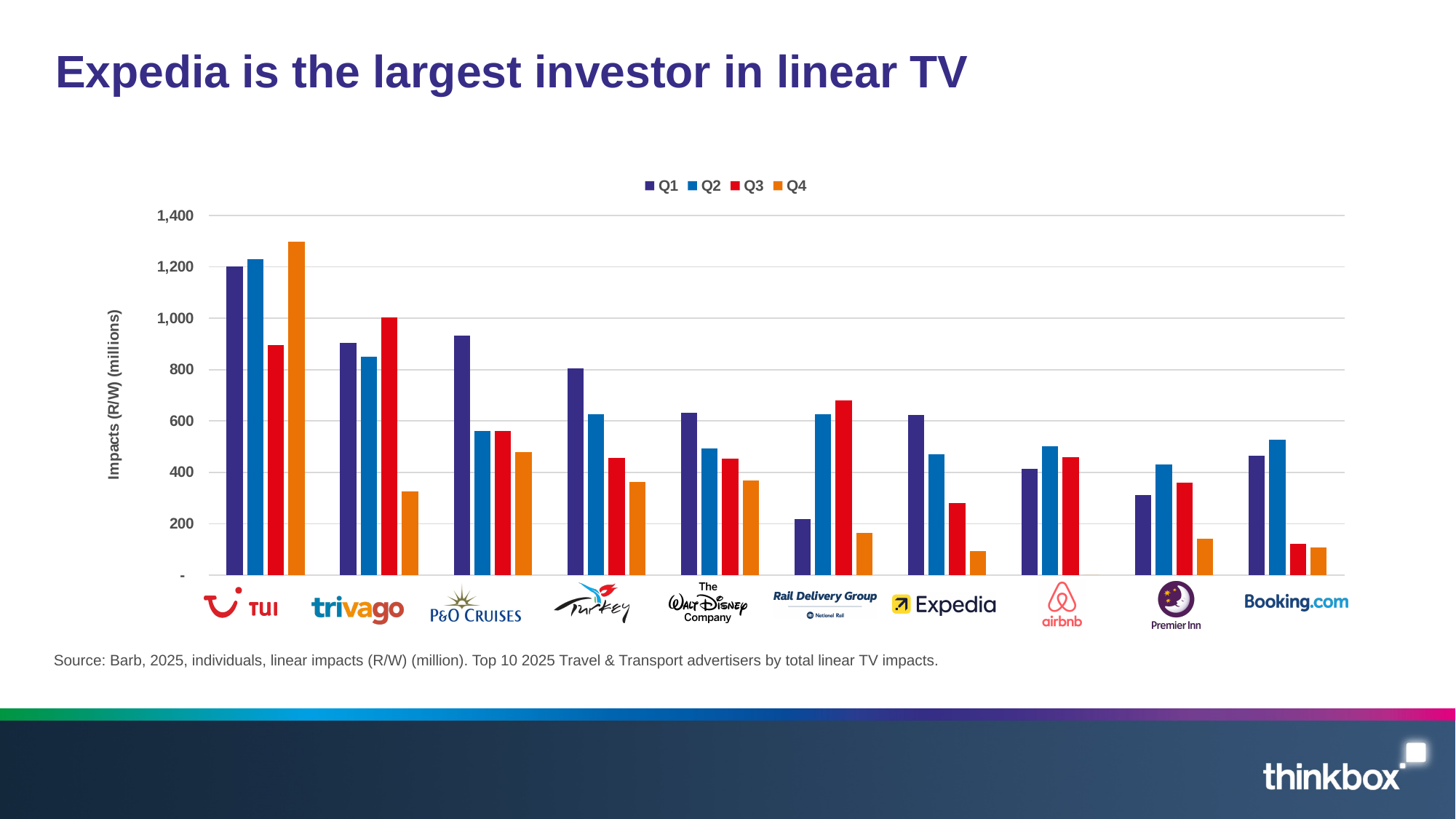
Which advertiser has the lowest Q1 value in the chart? Rail Delivery Group What is the label on the chart's y axis? Impacts (R/W) (millions) Is the Q1 value for P&O Cruises greater or less than 800? greater For Expedia, do the values rise or fall from Q1 to Q4? Fall Is the Q4 value for TUI greater or less than 1,200? greater Which advertiser has the highest Q4 value in the chart? TUI For Rail Delivery Group, which is larger: the Q1 value or the Q3 value? Q3 Is the Q4 value for Expedia greater or less than 200? less For trivago, which is larger: the Q1 value or the Q3 value? Q3 What kind of chart is shown on the slide? Bar chart How many advertisers are shown along the x axis of the chart? 10 How many series does the chart's legend list? 4